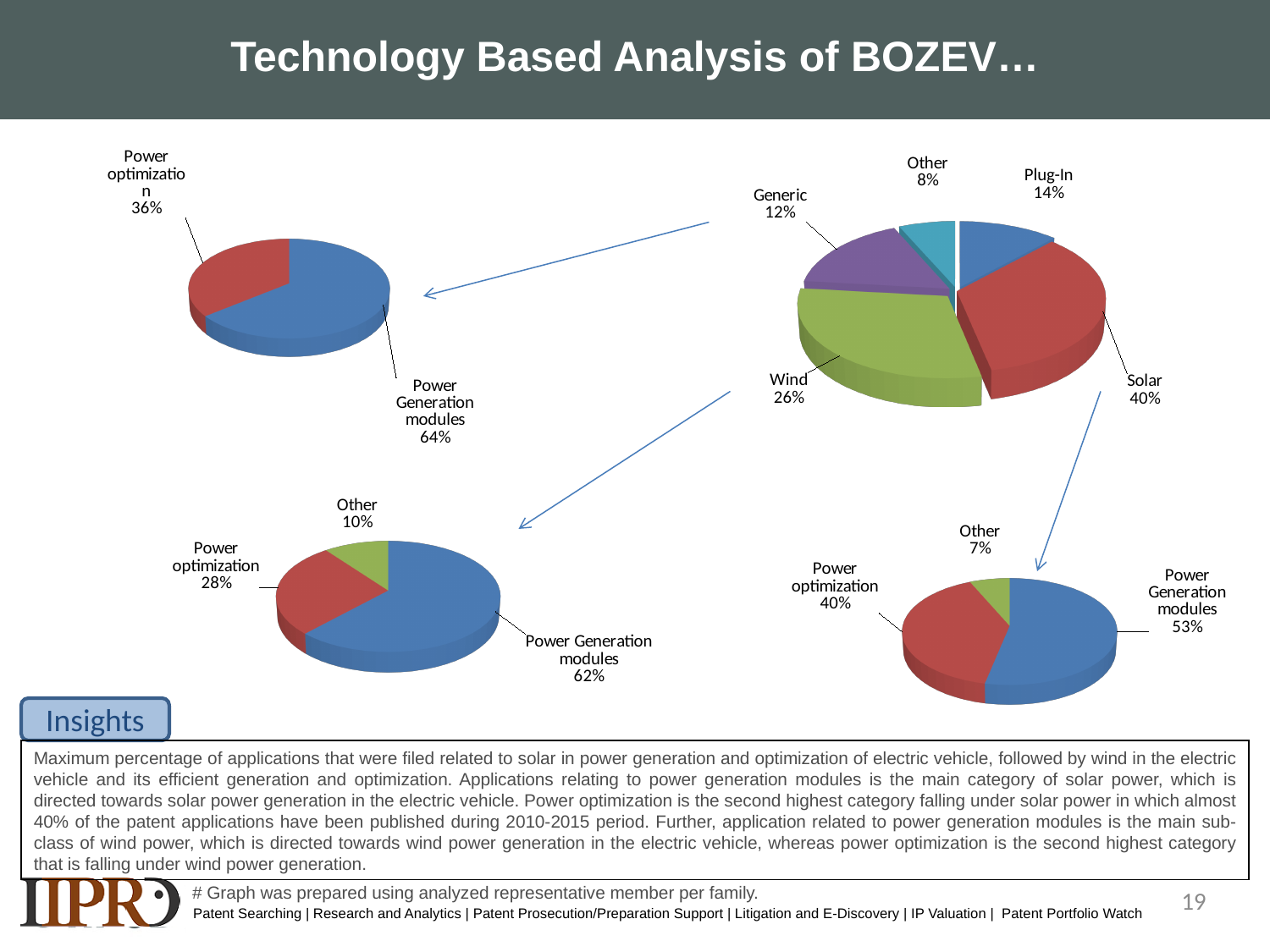
In the pie chart at the bottom right of the slide, which category has the largest share? Power Generation modules In the pie chart at the top left of the slide, what share do Power Generation modules have? 64% In the large pie chart at the top right of the slide, what is the difference between the Solar and Wind shares? 14% In the large pie chart at the top right of the slide, what share does Wind have? 26% In the large pie chart at the top right of the slide, what share does Solar have? 40% In the large pie chart at the top right of the slide, which category has the largest share? Solar In the large pie chart at the top right of the slide, how many categories are shown? 5 In the pie chart at the bottom left of the slide, what share does Power optimization have? 28% In the pie chart at the bottom right of the slide, what share does Other have? 7% In the large pie chart at the top right of the slide, which category has the smallest share? Other What type of chart is used for the large chart at the top right of the slide? Pie chart